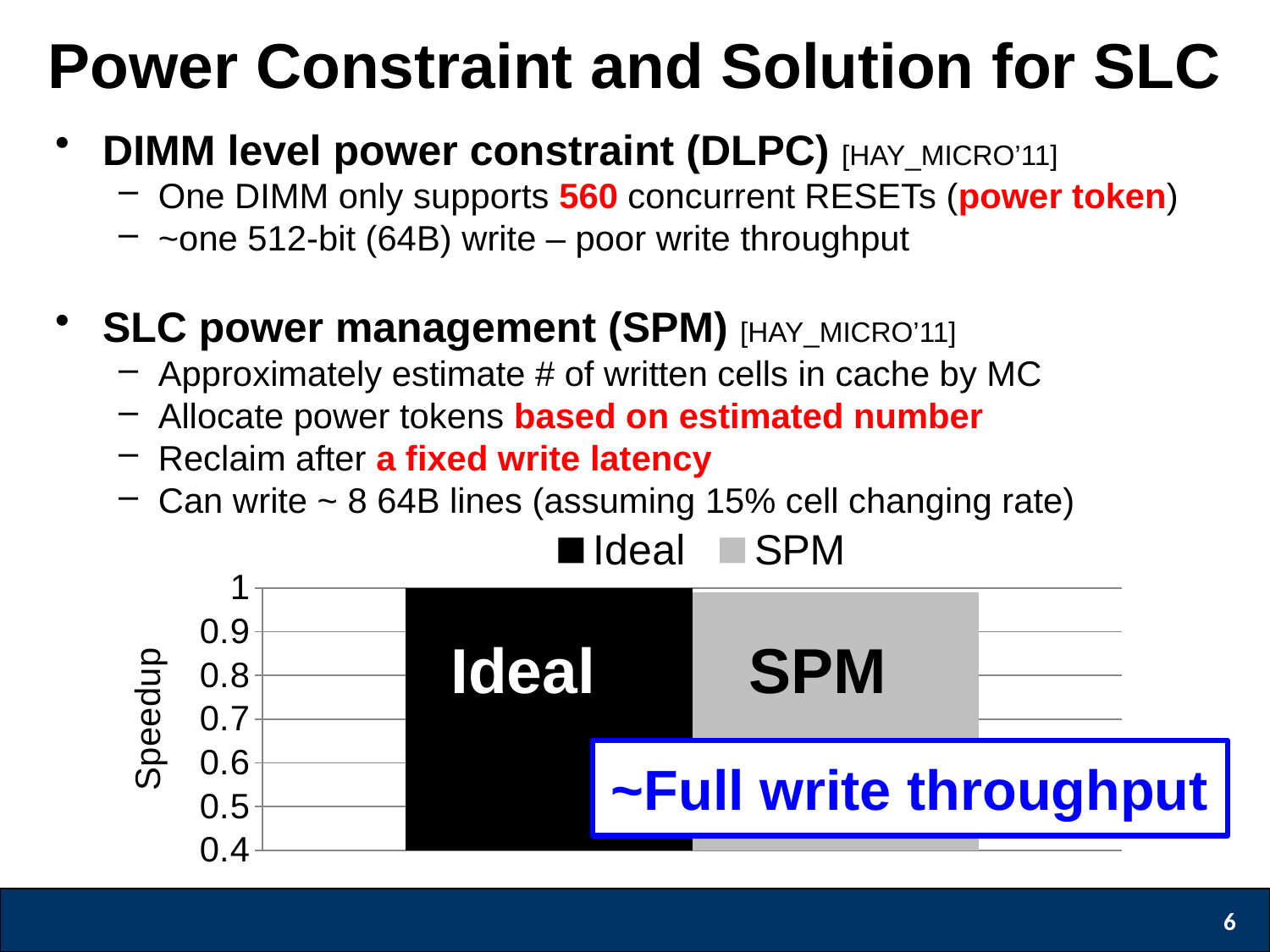
What is the lowest value shown on the vertical axis of the chart? 0.4 Is the speedup value for Ideal greater or less than 0.8? greater How many bars are plotted in the chart? 2 How many series does the chart legend list? 2 What is the speedup value for Ideal in the chart? 1 What are the two series named in the chart legend? Ideal and SPM Is the speedup value for SPM greater or less than 0.7? greater Is the speedup value for SPM greater or less than 0.9? greater What kind of chart is shown on the slide? bar chart What is the label on the vertical axis of the chart? Speedup